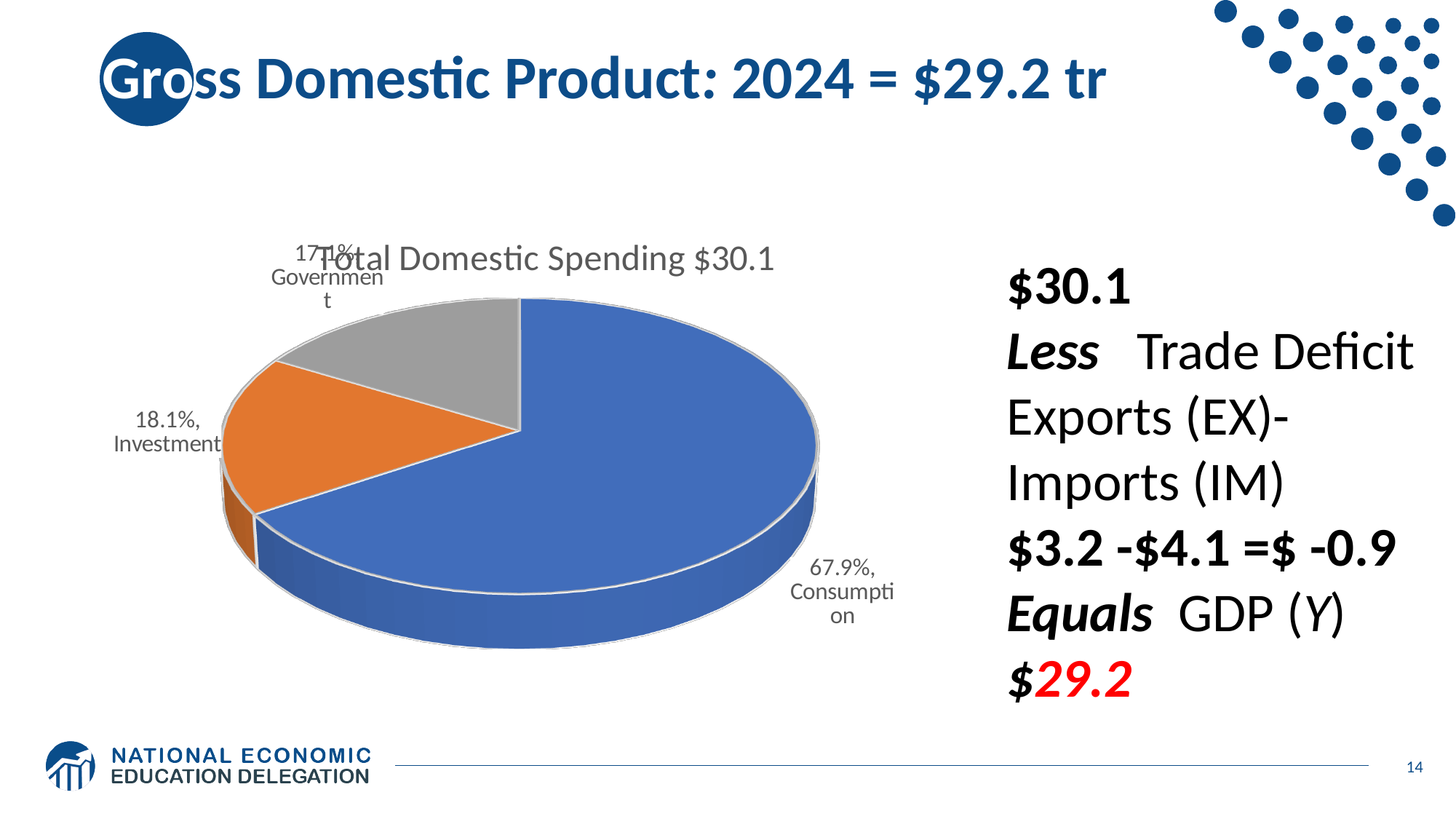
How many slices does the pie chart have? 3 Which category is represented by the orange slice of the pie chart? Investment What kind of chart is shown on the slide? pie chart What is the title of the pie chart? Total Domestic Spending $30.1 Which category has the largest slice of the pie chart? Consumption By how many percentage points does Consumption exceed Investment in the pie chart? 49.8 Which is larger in the pie chart, Consumption or Investment? Consumption What colour is the Consumption slice of the pie chart? blue What percentage is shown for Investment in the pie chart? 18.1% What share of total domestic spending is Consumption? 67.9%